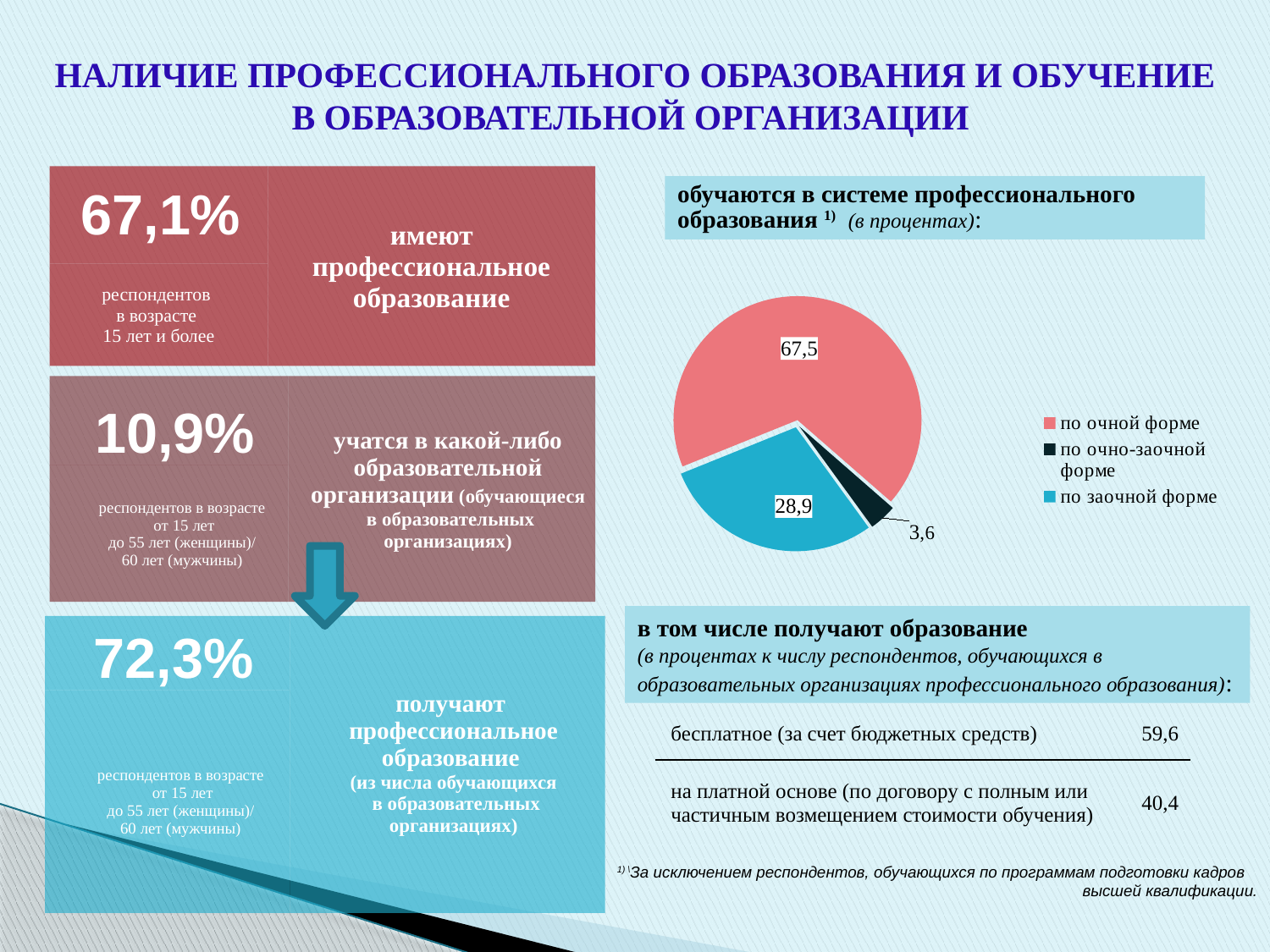
What value is shown for the slice "по очно-заочной форме" in the pie chart? 3,6 What is the difference between the values for "по заочной форме" and "по очно-заочной форме" in the pie chart? 25,3 Which is larger in the pie chart: "по заочной форме" or "по очно-заочной форме"? по заочной форме How many entries does the legend of the pie chart list? 3 What value is shown for the slice "по заочной форме" in the pie chart? 28,9 How many slices does the pie chart have? 3 What is the difference between the values for "по очной форме" and "по заочной форме" in the pie chart? 38,6 What type of chart is shown on the slide? pie chart Which category has the smallest slice in the pie chart? по очно-заочной форме What colour is the slice for "по заочной форме" in the pie chart? blue What value is shown for the slice "по очной форме" in the pie chart? 67,5 Which category has the largest slice in the pie chart? по очной форме